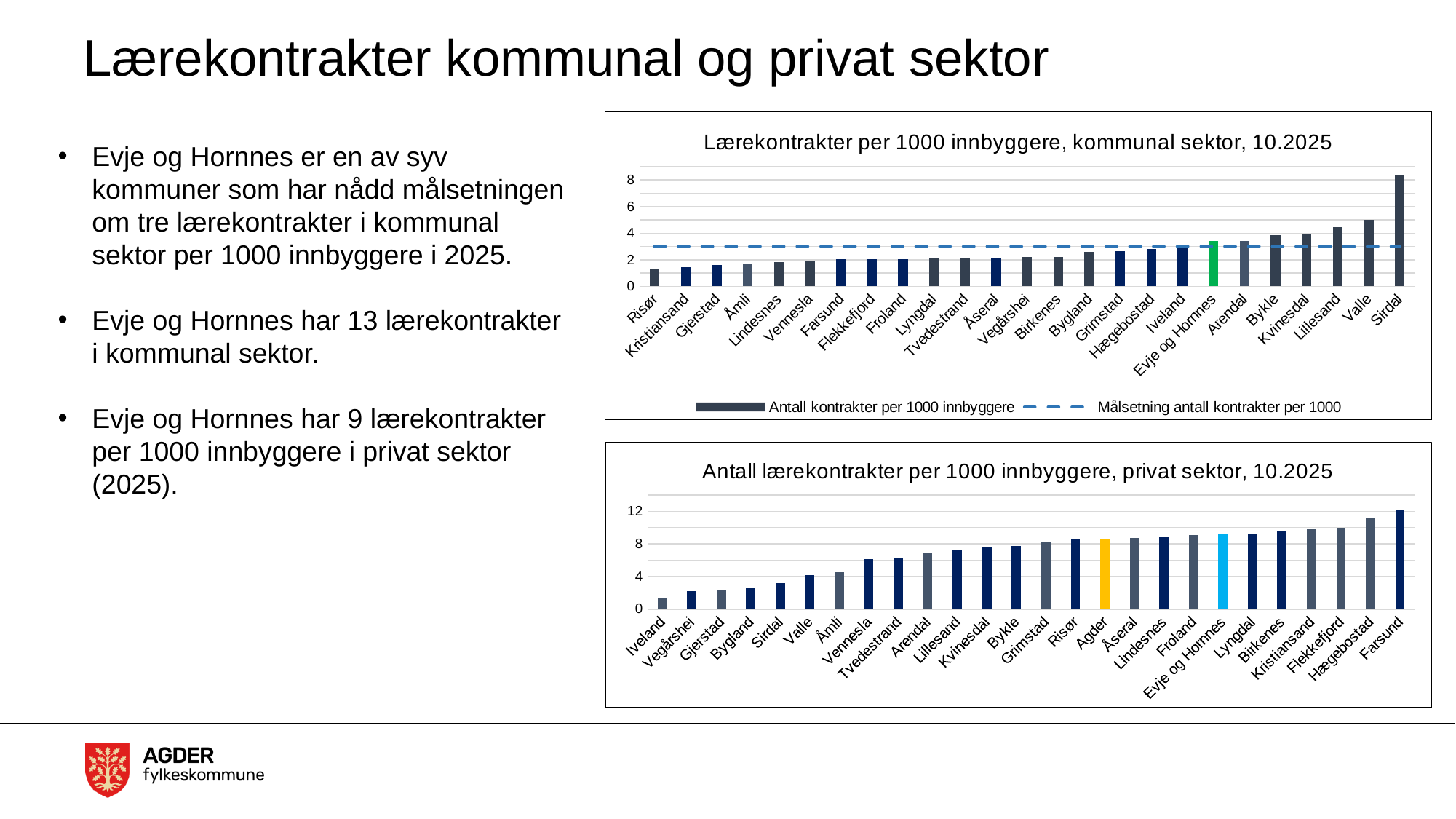
How many entries does the legend of the top chart (kommunal sektor) list? 2 In the bottom chart (privat sektor), which municipality has the lowest value? Iveland In the top chart (Lærekontrakter per 1000 innbyggere, kommunal sektor), which municipality has the highest value? Sirdal In the top chart (kommunal sektor), is the value for Sirdal greater or less than 6? greater In the bottom chart (privat sektor), do the values rise or fall from left to right along the x axis? rise In the top chart (kommunal sektor), is the value for Valle greater or less than 4? greater How many municipalities are shown in the top chart (kommunal sektor)? 25 What type of chart is the bottom chart (Antall lærekontrakter per 1000 innbyggere, privat sektor)? bar chart In the top chart (kommunal sektor), which municipality has the lowest value? Risør In the bottom chart (privat sektor), is the value for Evje og Hornnes greater or less than 8? greater In the bottom chart (privat sektor), which municipality has the highest value? Farsund